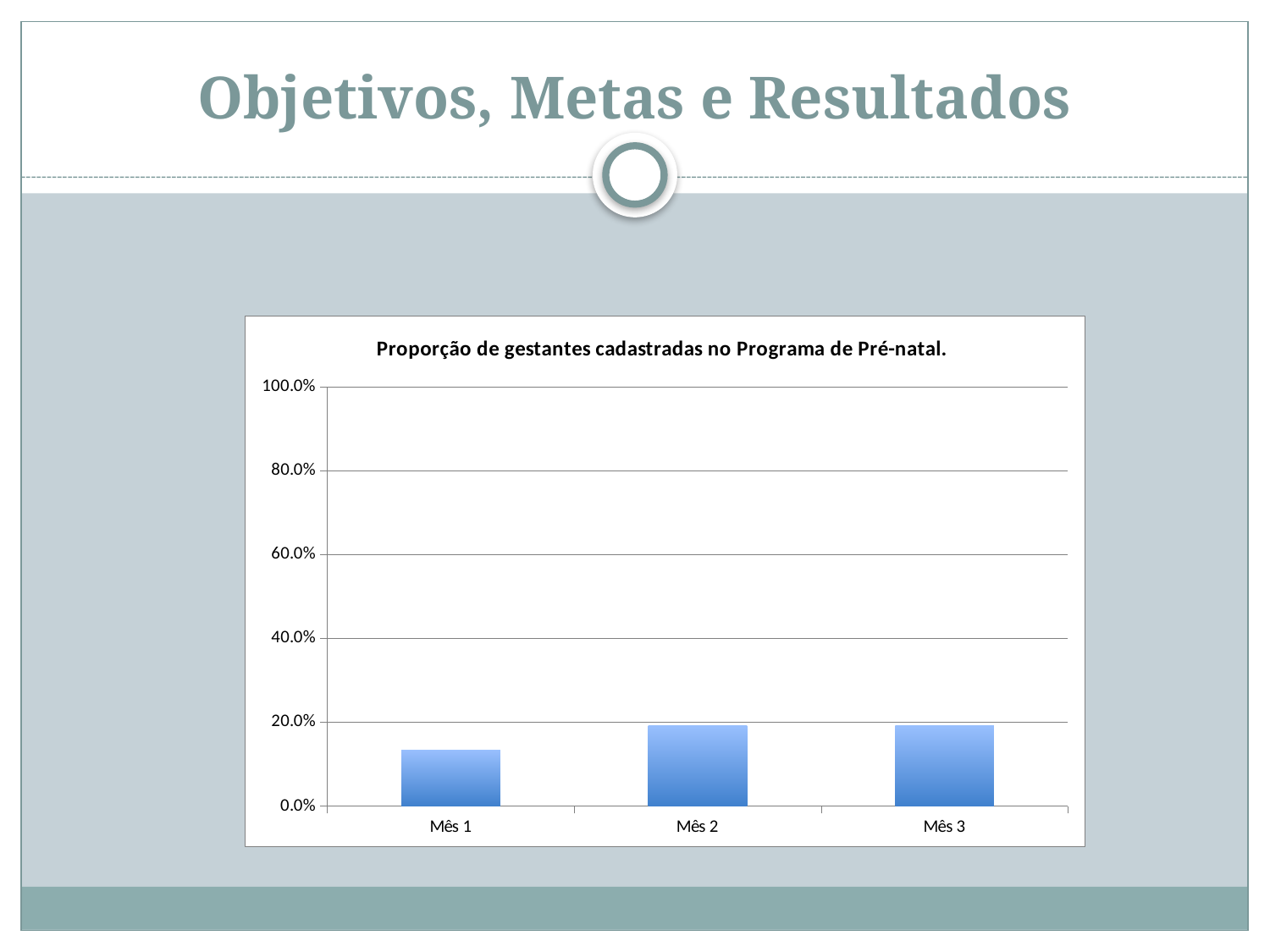
What is the title of the chart? Proporção de gestantes cadastradas no Programa de Pré-natal. What kind of chart is shown on the slide? bar chart Is the value for Mês 2 greater or less than 40.0%? less What is the highest value shown on the y axis of the chart? 100.0% How many categories are shown on the x axis of the chart? 3 Which is larger, the value for Mês 1 or the value for Mês 3? Mês 3 Is the value for Mês 1 greater or less than 20.0%? less Which category has the lowest value in the chart? Mês 1 Does the value rise or fall from Mês 1 to Mês 2? rise Which is larger, the value for Mês 1 or the value for Mês 2? Mês 2